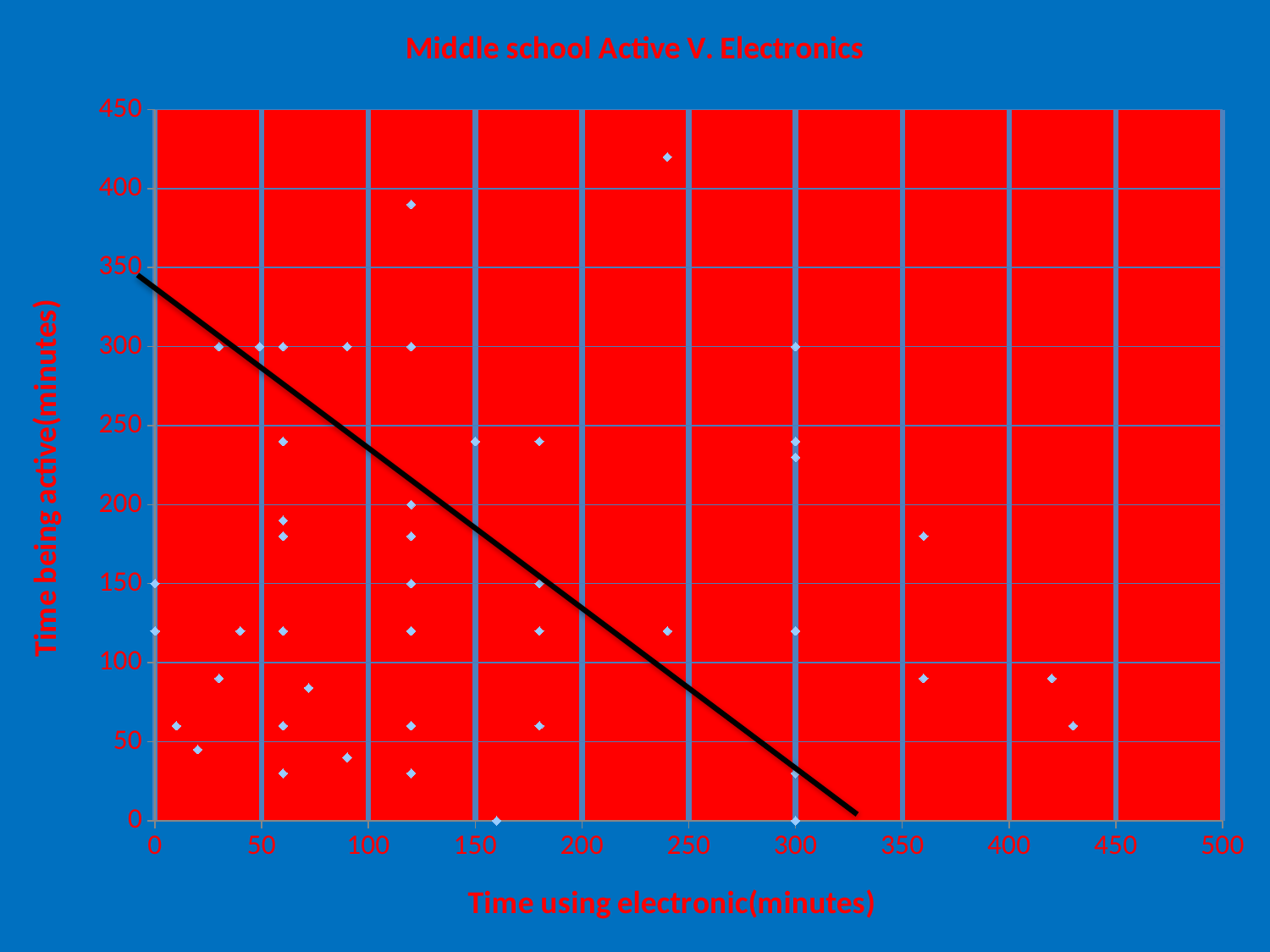
What is the label of the horizontal axis? Time using electronic(minutes) Does the black trend line rise or fall as time using electronics increases? Falls Is the highest plotted value of time being active greater or less than 400 minutes? greater What kind of chart is shown on the slide? Scatter chart What is the highest tick value shown on the vertical axis? 450 What is the title of the chart? Middle school Active V. Electronics Is the value of the trend line at 0 minutes of electronics use greater or less than 300 minutes of activity? greater Is the largest plotted value of time using electronics greater or less than 400 minutes? greater What is the highest tick value shown on the horizontal axis? 500